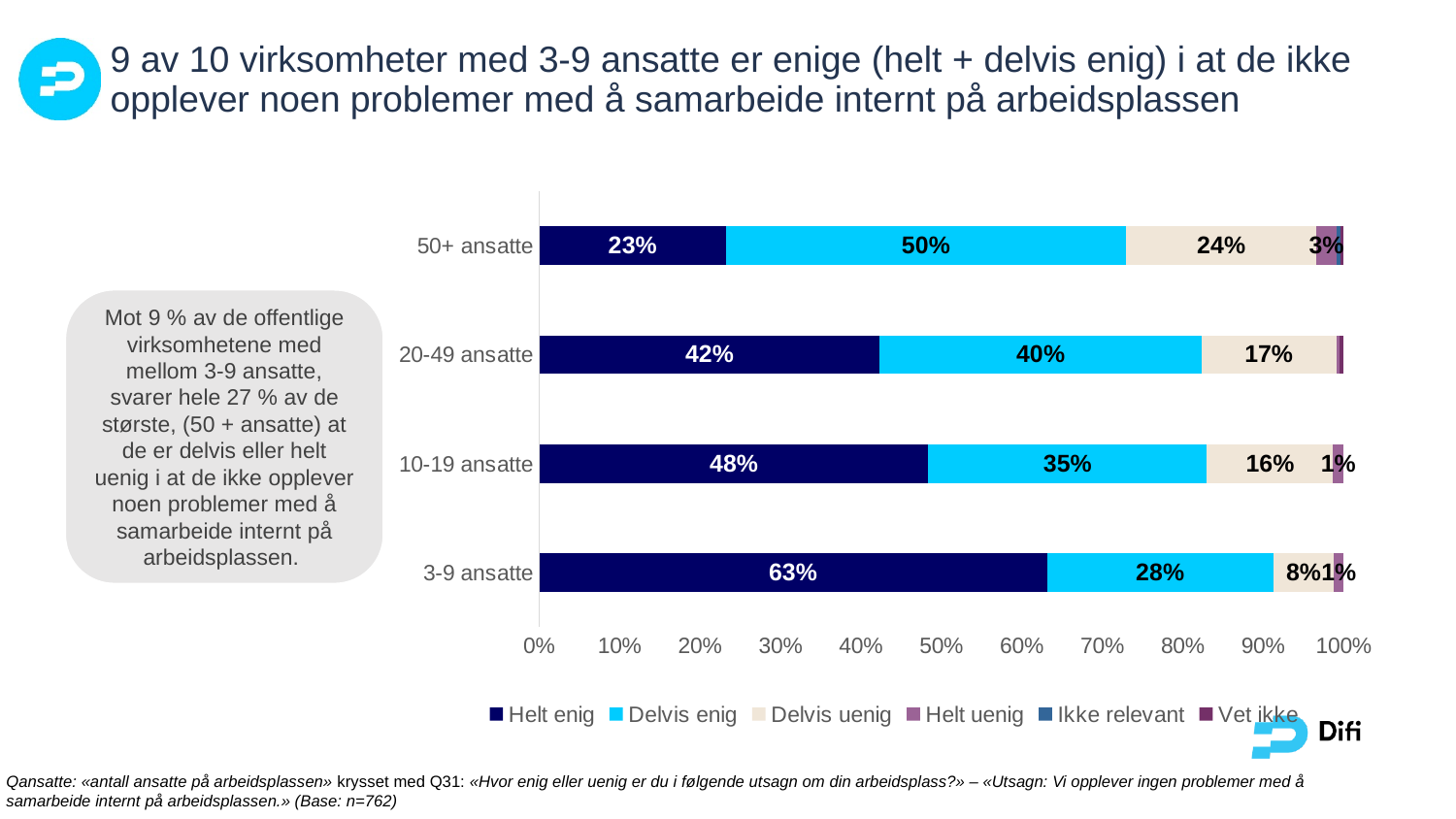
Which is larger: the 'Delvis uenig' value for 50+ ansatte or for 3-9 ansatte? 50+ ansatte What is the 'Delvis enig' value for 10-19 ansatte? 35% What kind of chart is shown on the slide? Stacked bar chart What is the 'Helt enig' value for 3-9 ansatte? 63% What is the difference between the 'Helt enig' values for 3-9 ansatte and 50+ ansatte? 40 percentage points Which category has the highest 'Helt enig' value? 3-9 ansatte Which series is listed first in the legend? Helt enig How many series does the legend list? 6 What is the 'Delvis enig' value for 50+ ansatte? 50% What is the 'Delvis uenig' value for 20-49 ansatte? 17% Which category has the lowest 'Helt enig' value? 50+ ansatte How many categories (company size groups) are shown on the chart? 4